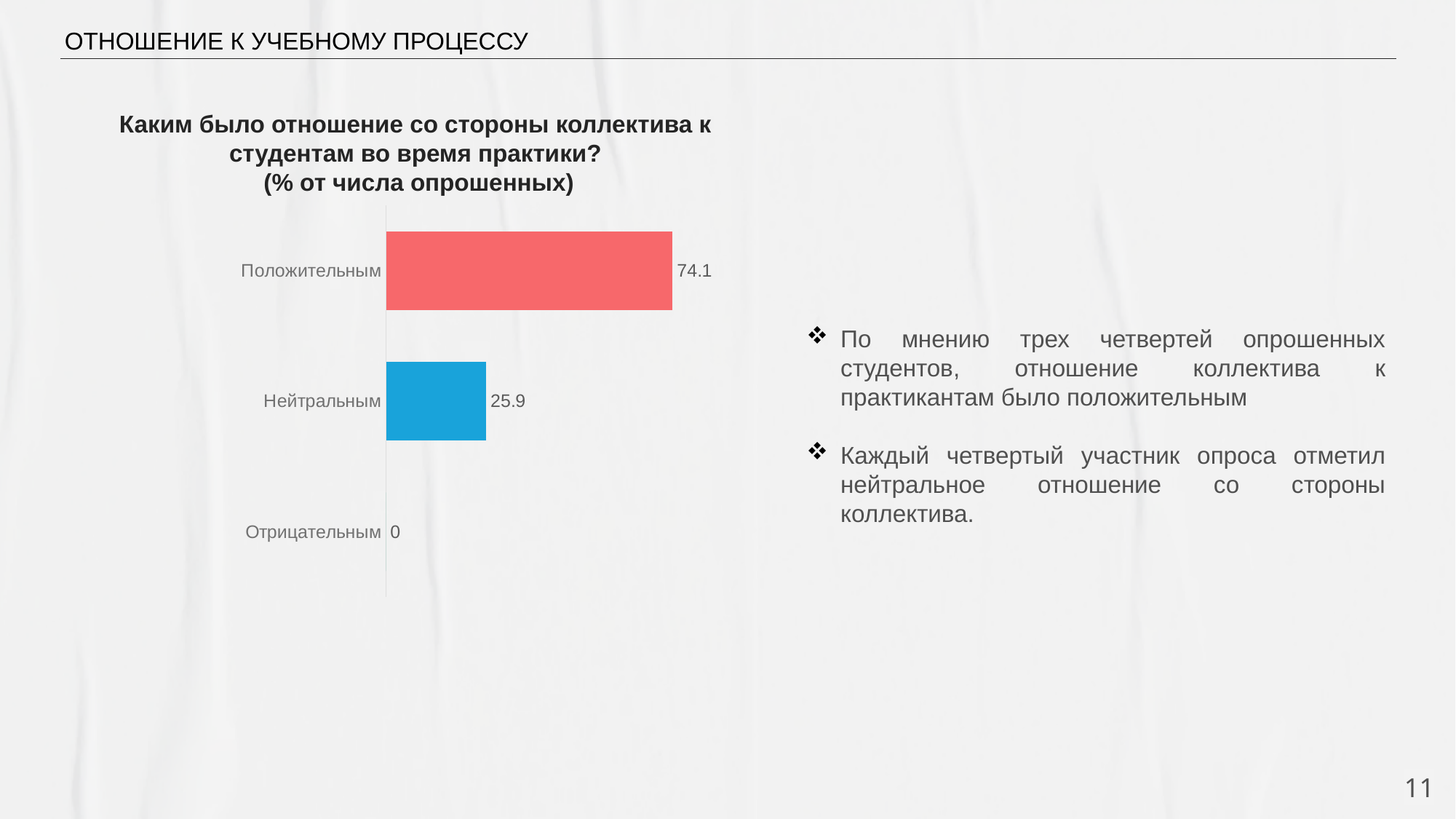
What is the value for Положительным? 74.1 What colour is the bar for Положительным? Red What is the difference between the values for Положительным and Нейтральным? 48.2 How many categories are shown in the chart? 3 What kind of chart is shown on the slide? Bar chart What colour is the bar for Нейтральным? Blue Which category has the lowest value? Отрицательным What is the value for Нейтральным? 25.9 Which is larger, the value for Нейтральным or the value for Отрицательным? Нейтральным Which category has the highest value? Положительным What is the value for Отрицательным? 0 What is the total of the values for Положительным and Нейтральным? 100